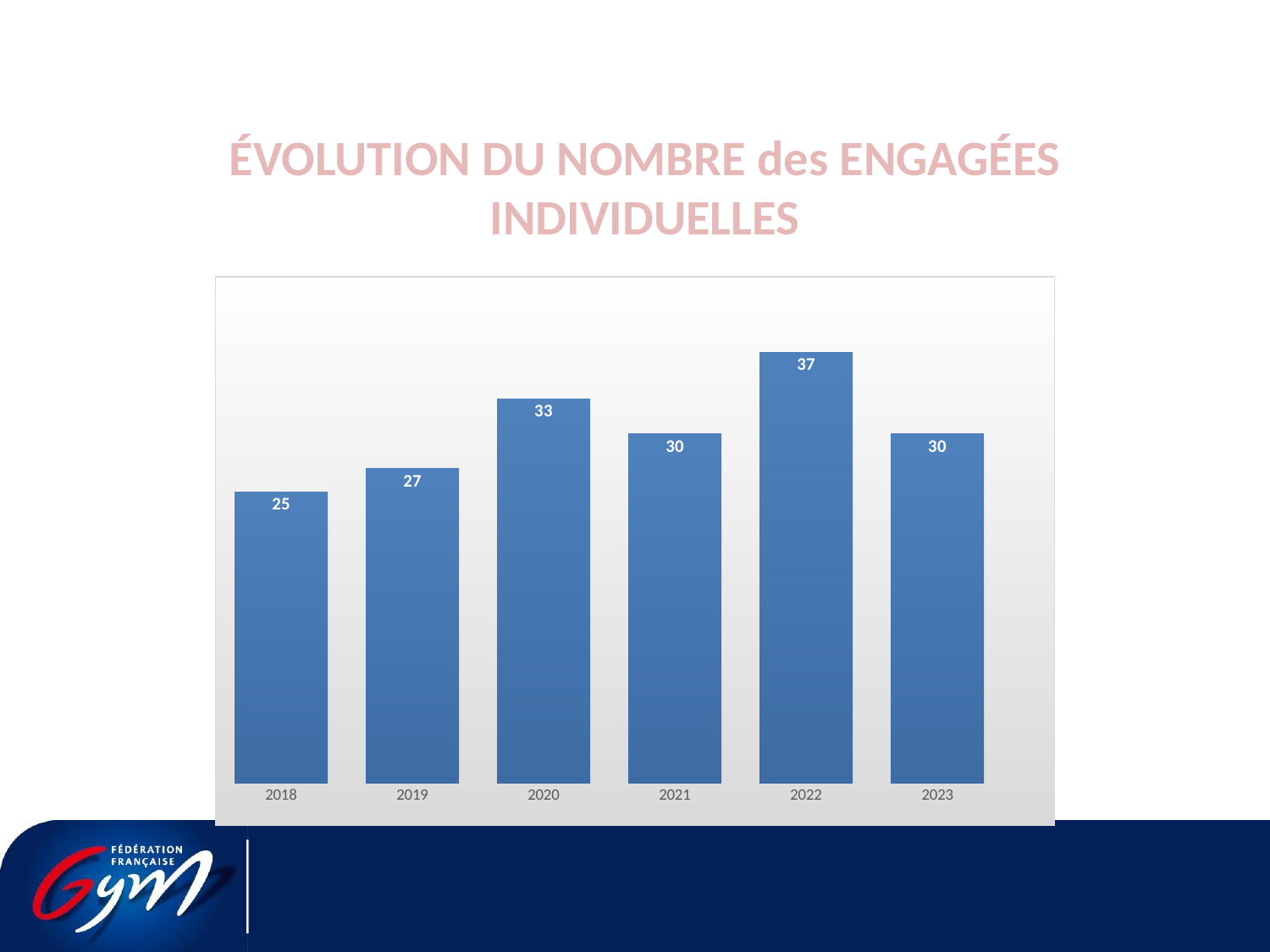
What is the difference between the values for 2022 and 2018? 12 Which is larger, the value for 2020 or the value for 2021? 2020 What is the difference between the values for 2020 and 2019? 6 Which year has the highest value? 2022 Which year has the lowest value? 2018 What is the title of the slide? ÉVOLUTION DU NOMBRE des ENGAGÉES INDIVIDUELLES What is the value for 2018? 25 What is the value for 2020? 33 How many years are shown on the x axis? 6 What is the value for 2022? 37 What kind of chart is shown on the slide? Bar chart Do the values rise or fall from 2018 to 2020? Rise